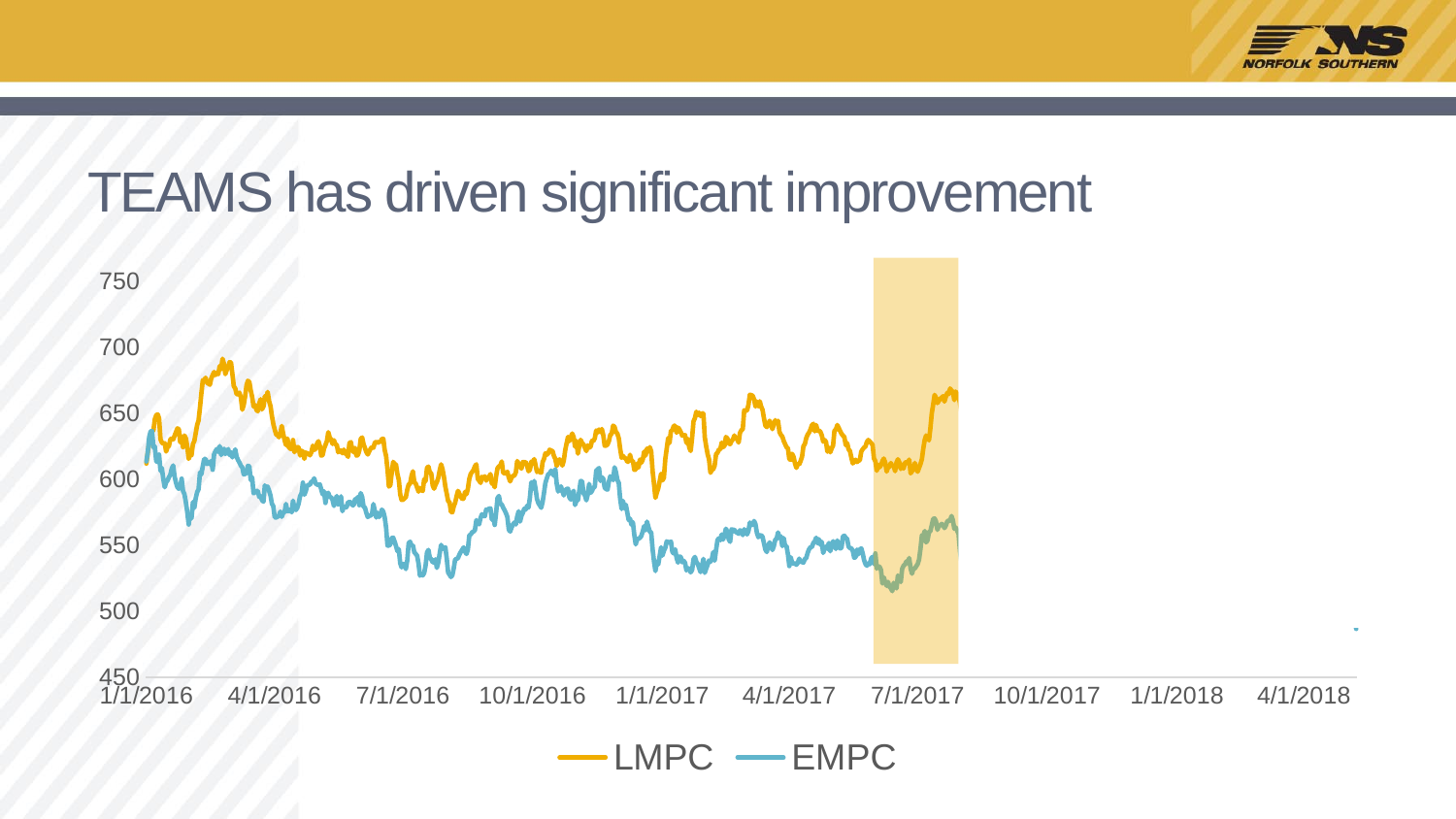
What is the title of the slide containing the chart? TEAMS has driven significant improvement What kind of chart is shown on the slide? Line chart Which series is plotted higher on the chart around 4/1/2017, LMPC or EMPC? LMPC How many series does the legend list? 2 Is the value of EMPC around 4/1/2017 greater or less than 600? less What are the two series named in the legend? LMPC and EMPC Does the EMPC line rise or fall between 1/1/2016 and 7/1/2016? fall What is the highest value shown on the vertical axis? 750 Is the lowest point of EMPC, inside the shaded region near 7/1/2017, greater or less than 550? less How many date labels are shown along the horizontal axis? 10 Is the value of EMPC around 7/1/2016 greater or less than 600? less